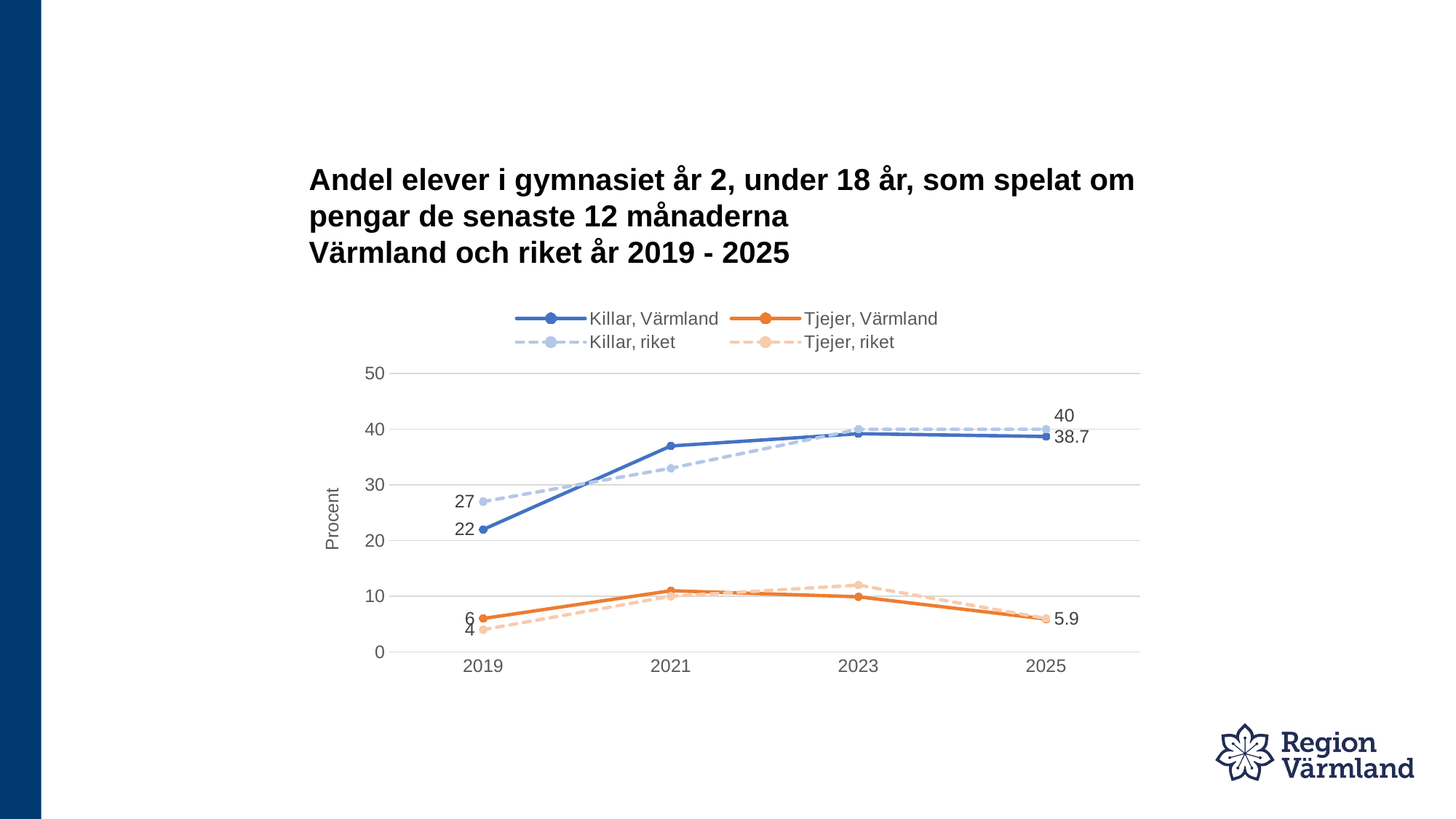
What is the label on the y axis? Procent What is the difference between Killar, riket and Killar, Värmland in 2019? 5 What kind of chart is shown on the slide? Line chart What is the value for Killar, Värmland in 2019? 22 Is the value for Killar, Värmland in 2021 greater or less than 30? greater What is the value for Killar, Värmland in 2025? 38.7 What is the value for Tjejer, Värmland in 2019? 6 How many series does the legend list? 4 What is the value for Tjejer, riket in 2019? 4 What is the value for Killar, riket in 2025? 40 How many years are shown on the x axis? 4 What is the value for Killar, riket in 2019? 27